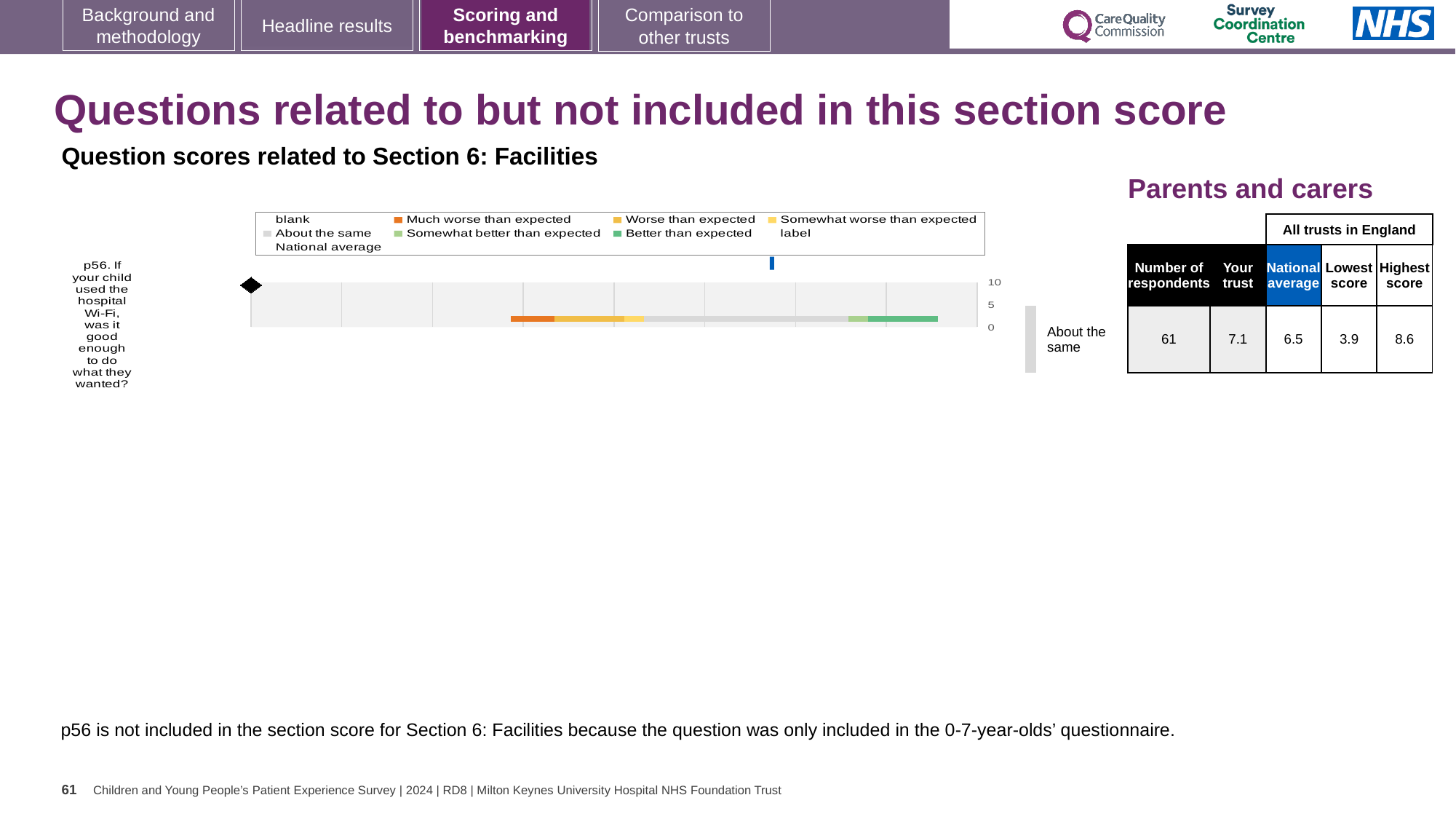
What kind of chart is used to show the p56 question score? bar chart What is the lowest score among all trusts in England for p56? 3.9 What benchmark category label is shown beside the chart for p56? About the same How many respondents answered p56? 61 What is the highest score among all trusts in England for p56? 8.6 How many questions are plotted in the chart? 1 What is the maximum value shown on the chart's score axis? 10 What is the difference between the highest score and the lowest score for p56? 4.7 Which is higher for p56: the 'Your trust' score or the national average? Your trust By how much does the 'Your trust' score for p56 exceed the national average? 0.6 What is the 'Your trust' score for p56 shown in the table next to the chart? 7.1 What is the national average score for p56? 6.5